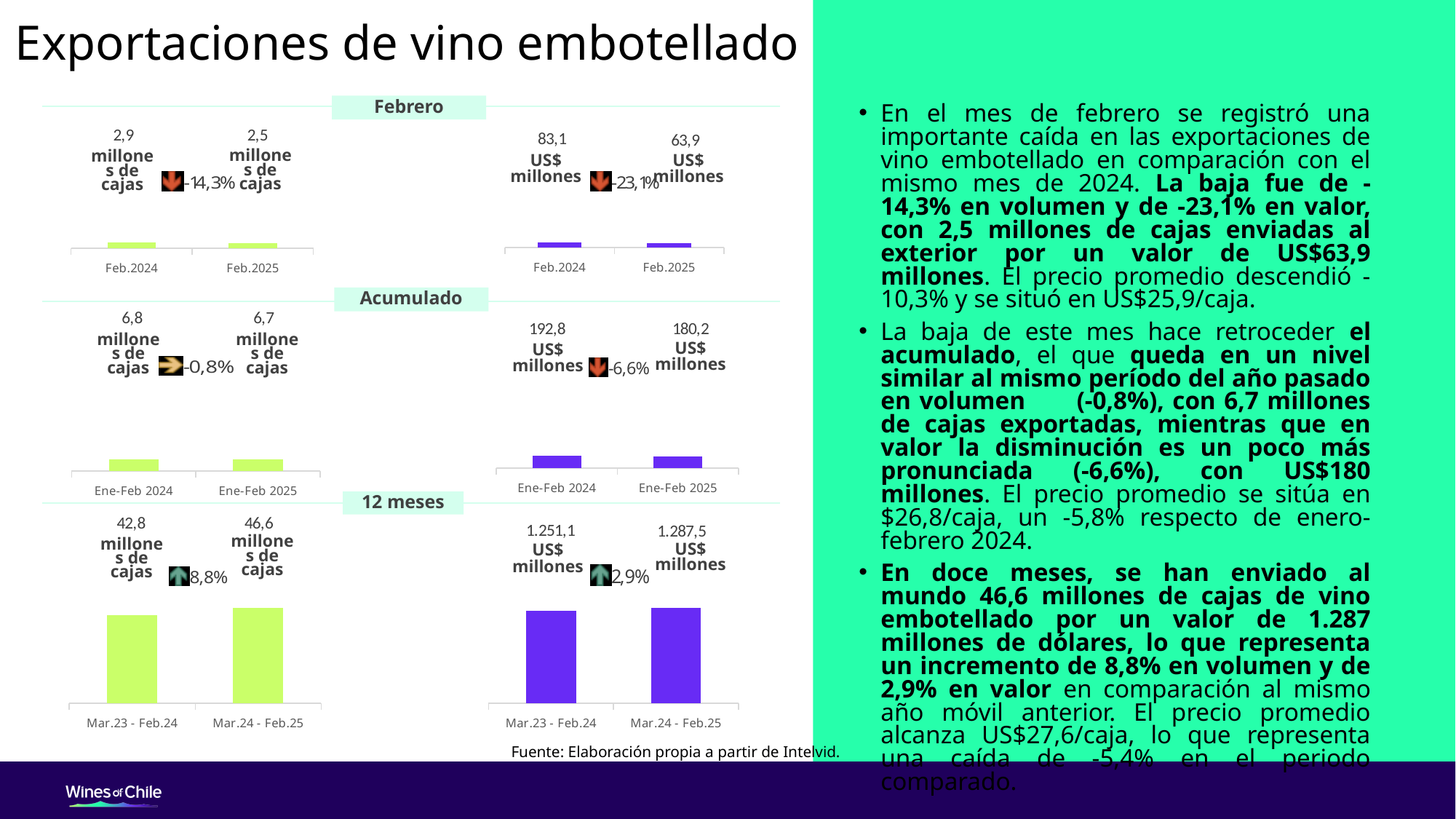
In the Febrero section, right chart (US$ millones), what is the difference between Feb.2024 and Feb.2025? 19,2 In the 12 meses section, right chart (US$ millones), what is the value for Mar.23 - Feb.24? 1.251,1 In the Acumulado section, right chart (US$ millones), what is the difference between Ene-Feb 2024 and Ene-Feb 2025? 12,6 How many categories does the Febrero left chart (millones de cajas) show? 2 In the Febrero section, left chart (millones de cajas), what is the value for Feb.2025? 2,5 In the 12 meses section, right chart (US$ millones), which category is the highest? Mar.24 - Feb.25 In the Febrero section, right chart (US$ millones), what is the value for Feb.2024? 83,1 What type of chart is used in the 12 meses section? Bar chart In the 12 meses section, left chart (millones de cajas), what is the difference between Mar.24 - Feb.25 and Mar.23 - Feb.24? 3,8 In the 12 meses section, left chart (millones de cajas), what is the value for Mar.24 - Feb.25? 46,6 In the Acumulado section, right chart (US$ millones), which category is higher, Ene-Feb 2024 or Ene-Feb 2025? Ene-Feb 2024 In the Acumulado section, left chart (millones de cajas), what is the value for Ene-Feb 2025? 6,7